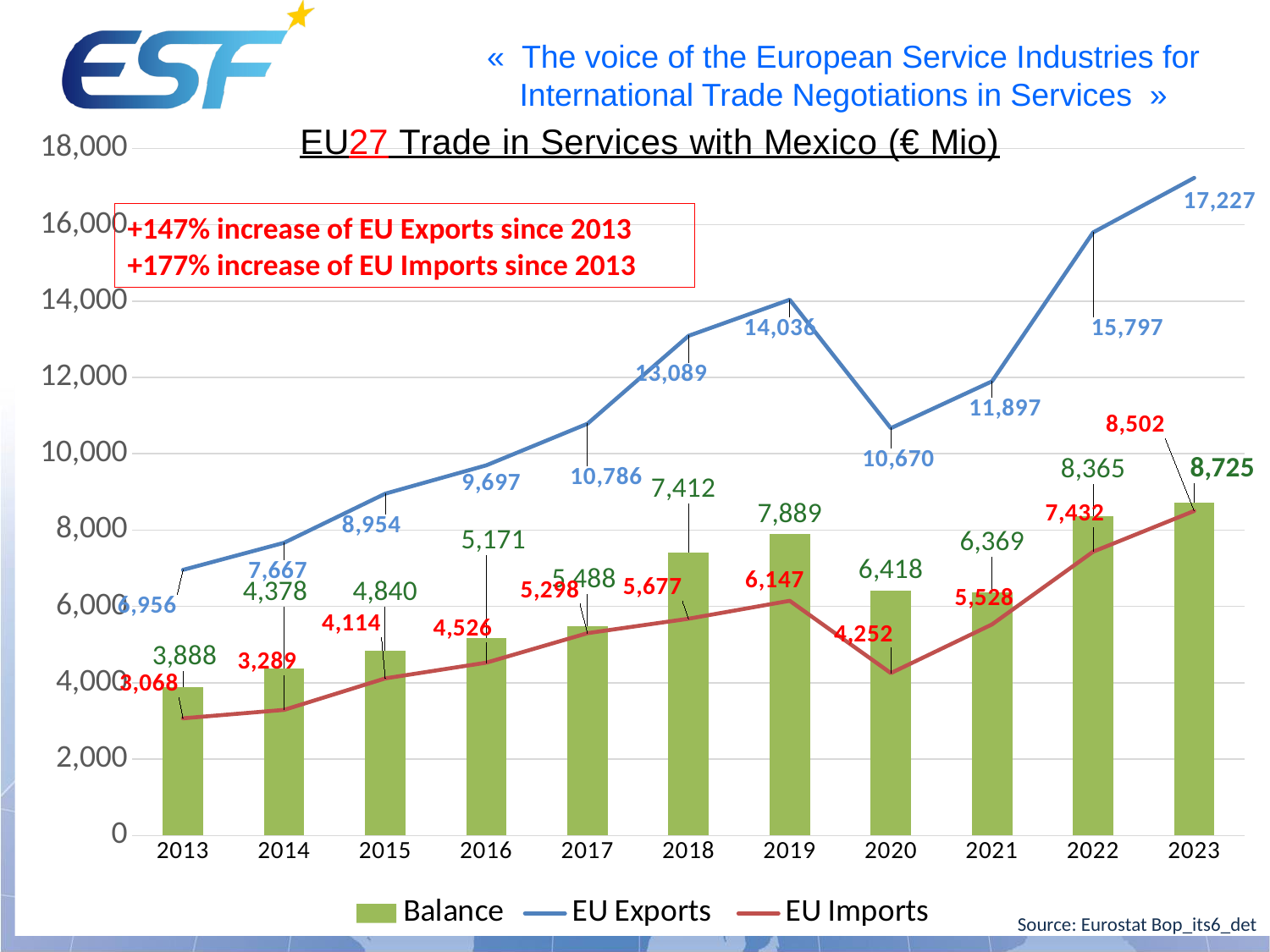
How many series does the legend list? 3 How many years are shown on the x axis? 11 What is the difference between EU Exports in 2019 and EU Exports in 2020? 3,366 What kind of chart is this? Combined bar and line chart What is the Balance value for 2018? 7,412 In which year are EU Exports highest? 2023 What is the value of EU Imports in 2020? 4,252 In which year are EU Imports lowest? 2013 Which is larger: EU Exports in 2018 or EU Exports in 2021? EU Exports in 2018 What is the value of EU Exports in 2023? 17,227 Is the value of EU Imports in 2022 greater or less than 6,000? greater What is the title of the chart? EU27 Trade in Services with Mexico (€ Mio)